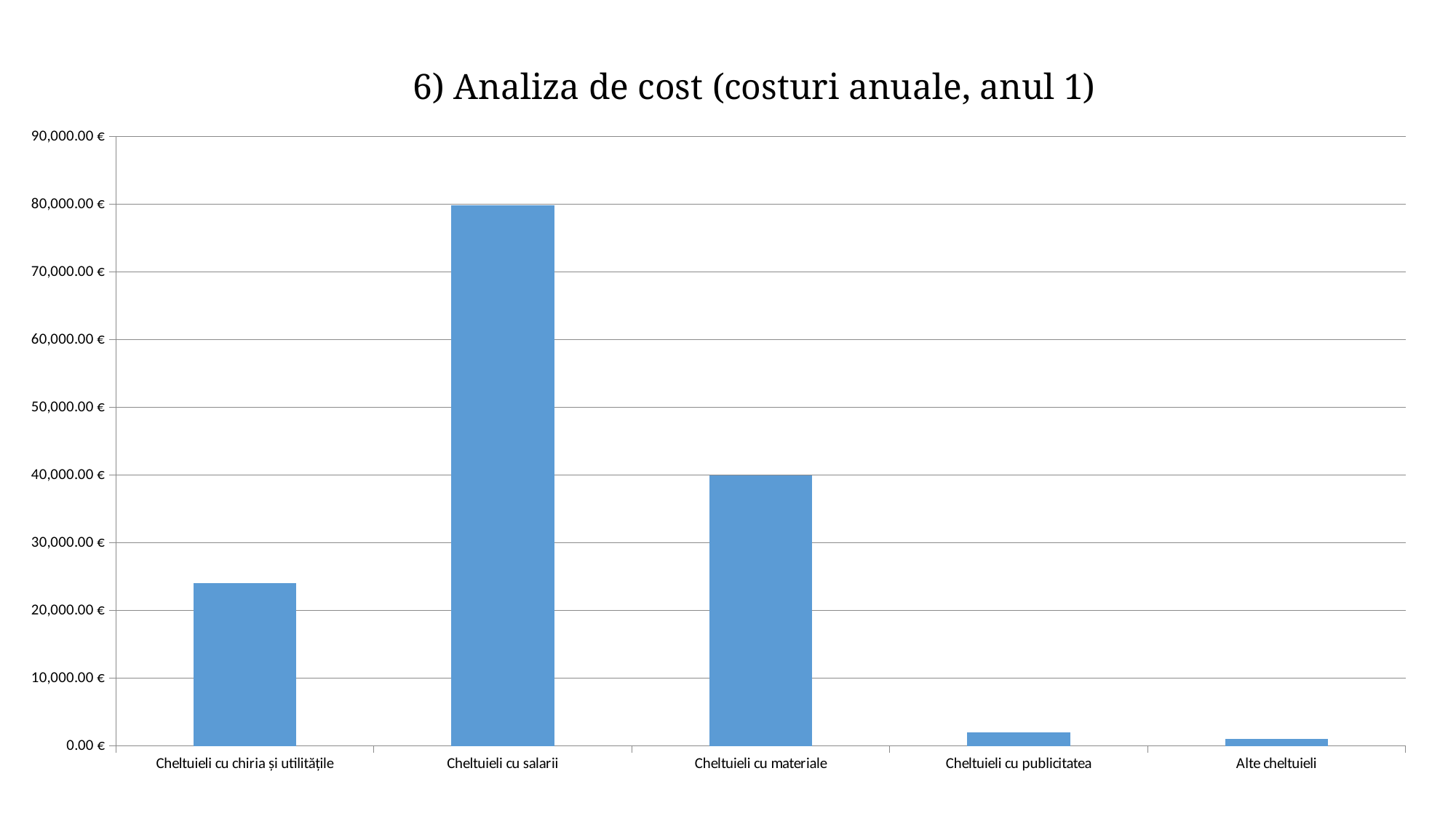
Is the value for Cheltuieli cu chiria și utilitățile greater or less than 30,000.00 €? less Which category has the lowest annual cost? Alte cheltuieli What is the title of the chart? 6) Analiza de cost (costuri anuale, anul 1) Is the value for Cheltuieli cu chiria și utilitățile greater or less than 20,000.00 €? greater Which is larger: the cost for Cheltuieli cu chiria și utilitățile or for Cheltuieli cu materiale? Cheltuieli cu materiale Which category has the highest annual cost? Cheltuieli cu salarii What kind of chart is shown on the slide? bar chart Is the value for Cheltuieli cu publicitatea greater or less than 10,000.00 €? less Which is larger: the cost for Cheltuieli cu publicitatea or for Alte cheltuieli? Cheltuieli cu publicitatea What is the value for Cheltuieli cu materiale? 40,000.00 € How many cost categories are plotted on the chart? 5